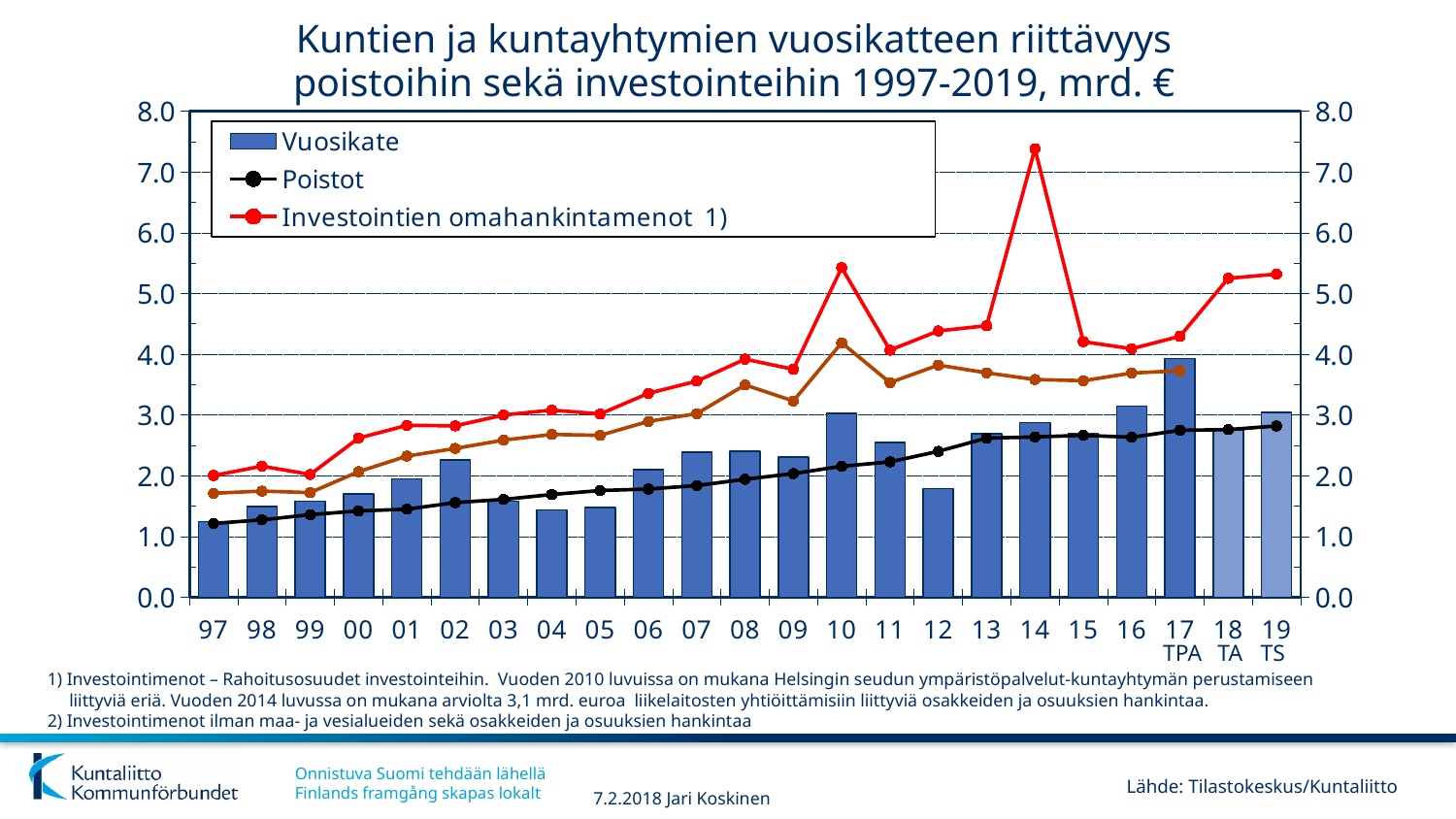
Does the Poistot line generally rise or fall from 97 to 19? rise Which is larger, the Vuosikate bar for 17 or for 12? 17 How many series does the legend list? 3 Is the Investointien omahankintamenot value for 14 greater or less than 7.0? greater Is the Poistot value for 97 greater or less than 2.0? less What is the unit stated in the chart title? mrd. € What kind of chart is shown on the slide? A combined bar and line chart How many years are shown along the x axis? 23 Is the Vuosikate value for 17 greater or less than 3.0? greater In which year does the Investointien omahankintamenot line reach its highest value? 14 In which year is the Vuosikate bar the tallest? 17 In which year is the Vuosikate bar the lowest? 97